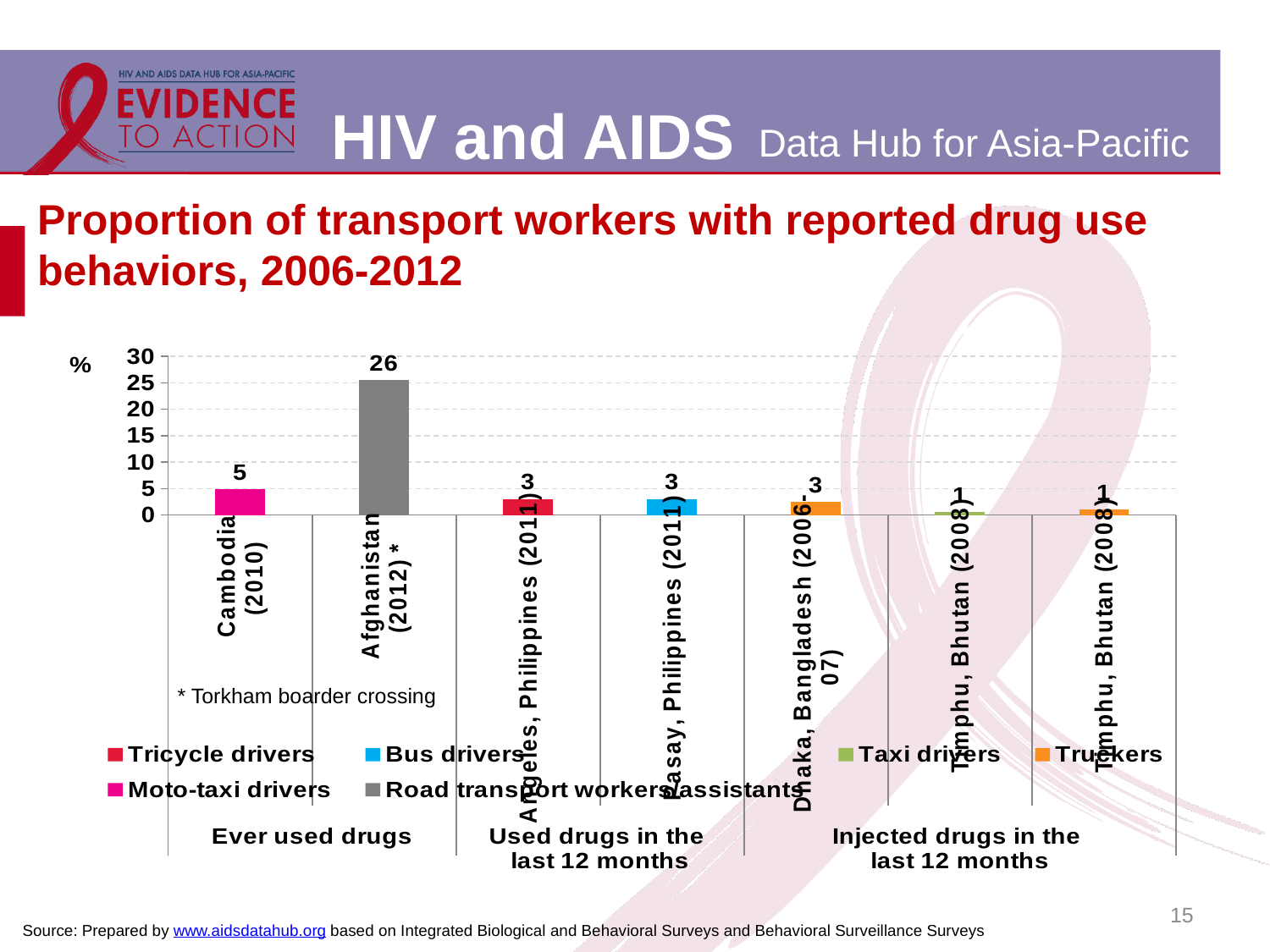
Which is larger, the value for Cambodia (2010) or the value for Pasay, Philippines (2011)? Cambodia (2010) What is the value shown for Thimphu, Bhutan (2008) under Injected drugs in the last 12 months? 1 What is the difference between the values for Afghanistan (2012) and Cambodia (2010)? 21 How many bars are plotted in the chart? 7 Which category has the highest value? Afghanistan (2012) Is the value for Afghanistan (2012) greater or less than 20? greater What is the value for Cambodia (2010)? 5 What is the value for Angeles, Philippines (2011)? 3 What is the value for Dhaka, Bangladesh (2006-07)? 3 What kind of chart is shown on the slide? bar chart What is the value for Afghanistan (2012)? 26 How many series does the legend list? 6